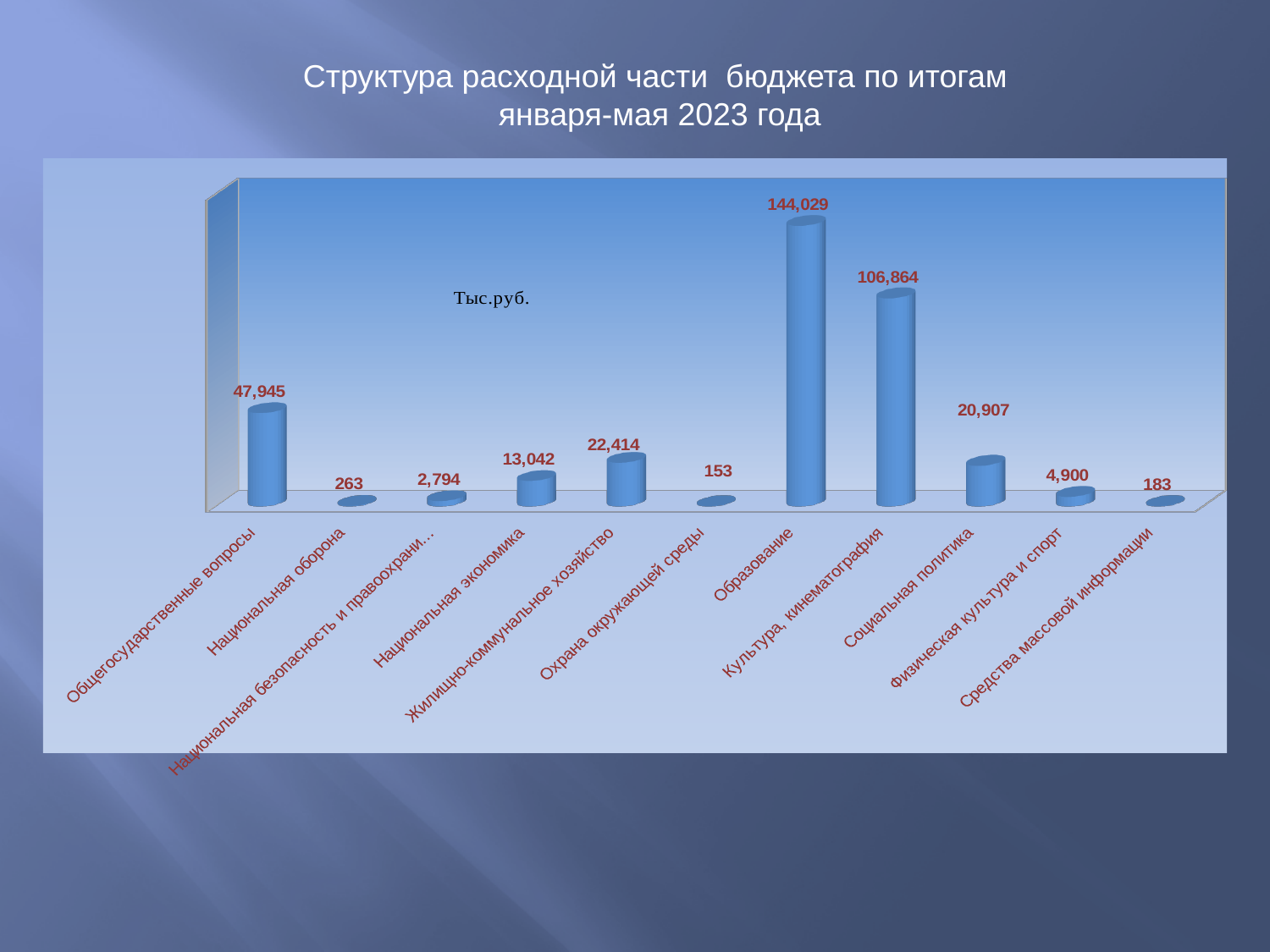
Which category has the highest value? Образование What is the value for Общегосударственные вопросы? 47,945 How many categories are shown in the chart? 11 What is the difference between the values for Общегосударственные вопросы and Жилищно-коммунальное хозяйство? 25,531 What is the value for Культура, кинематография? 106,864 What is the difference between the values for Образование and Культура, кинематография? 37,165 What is the value for Социальная политика? 20,907 Which category has the lowest value? Охрана окружающей среды What unit is indicated on the chart? Тыс.руб. What is the value for Физическая культура и спорт? 4,900 Which is larger, the value for Национальная экономика or the value for Жилищно-коммунальное хозяйство? Жилищно-коммунальное хозяйство What is the value for Образование? 144,029